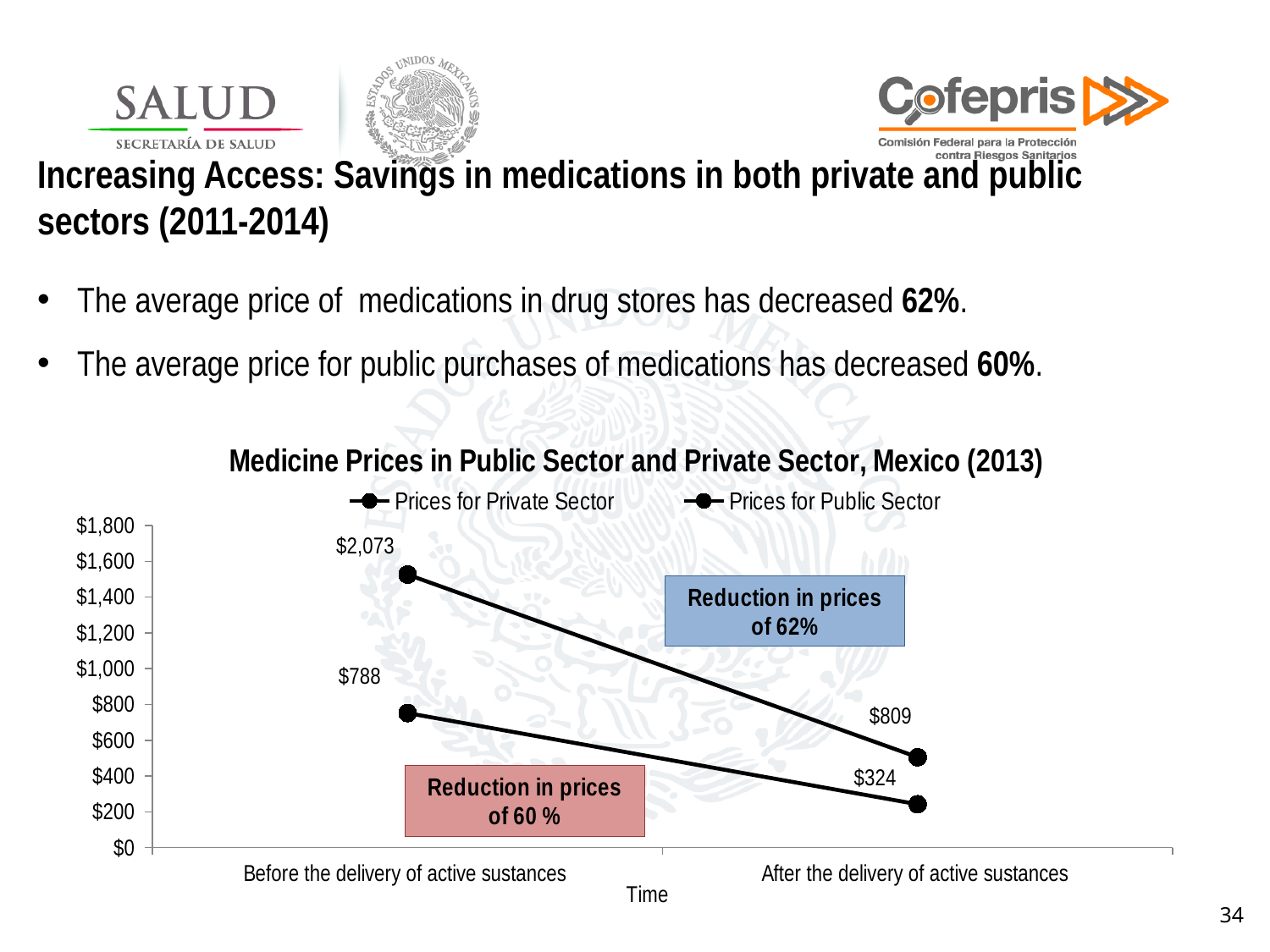
What is the price for the Public Sector before the delivery of active substances? $788 What kind of chart is shown on the slide? Line chart What is the price for the Private Sector before the delivery of active substances? $2,073 What is the title of the chart? Medicine Prices in Public Sector and Private Sector, Mexico (2013) By how much did the Private Sector price fall from before to after the delivery of active substances? $1,264 How many categories are shown on the x axis? 2 How many series does the legend list? 2 Do the prices for the Public Sector rise or fall from before to after the delivery of active substances? Fall What is the price for the Private Sector after the delivery of active substances? $809 Which series has the higher price after the delivery of active substances, Private Sector or Public Sector? Prices for Private Sector By how much did the Public Sector price fall from before to after the delivery of active substances? $464 What is the price for the Public Sector after the delivery of active substances? $324